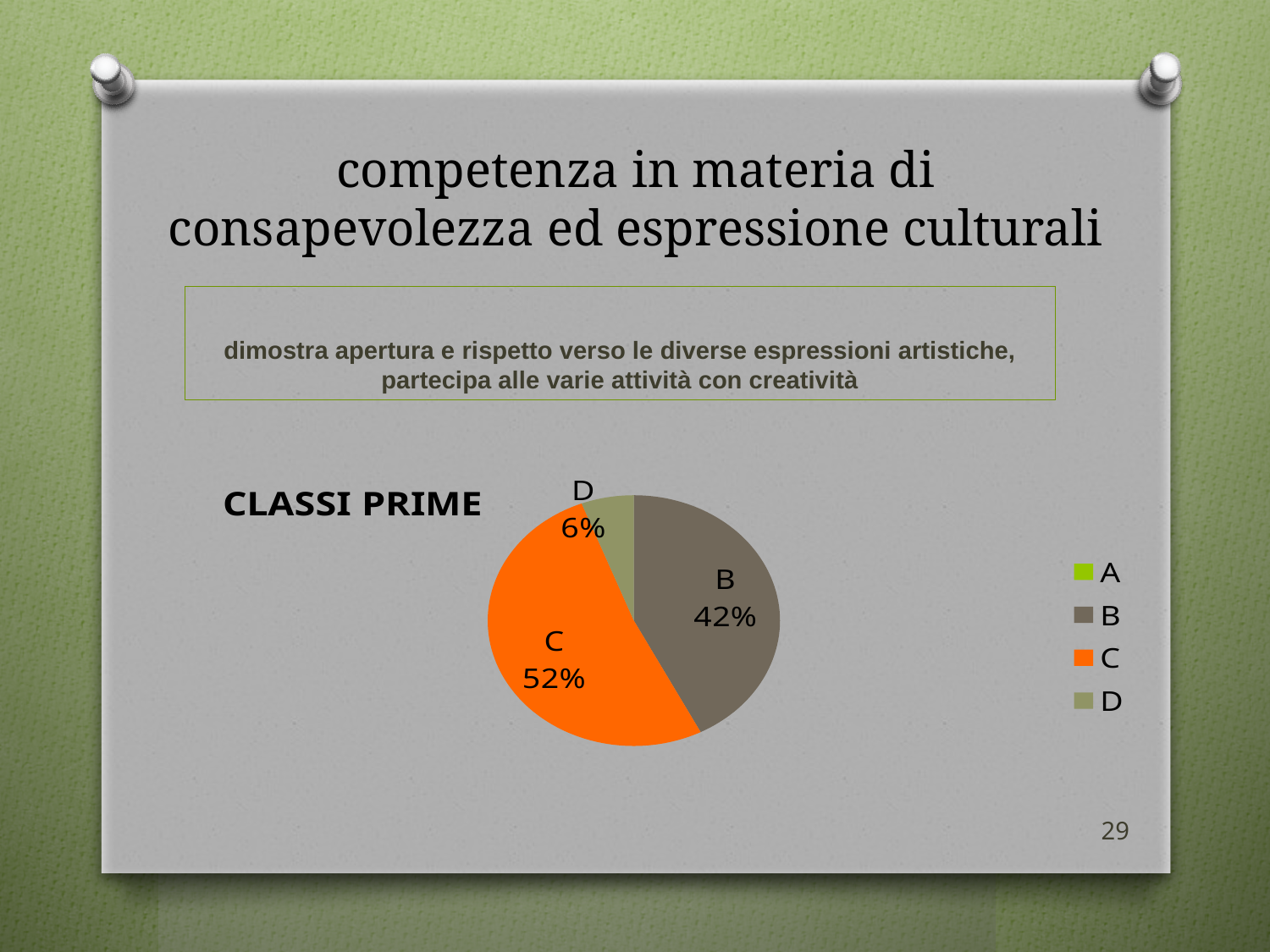
What kind of chart is shown on the slide? pie chart What is the difference between the shares of C and B in the pie chart? 10% How many entries does the legend of the pie chart list? 4 What is the share for category C in the pie chart? 52% What colour is the slice for category C in the pie chart? orange What is the difference between the shares of B and D in the pie chart? 36% What label appears to the left of the pie chart? CLASSI PRIME What is the share for category B in the pie chart? 42% Which labelled category has the smallest slice in the pie chart? D What is the share for category D in the pie chart? 6% Which category has the largest slice in the pie chart? C Which is larger in the pie chart, the share for B or the share for C? C